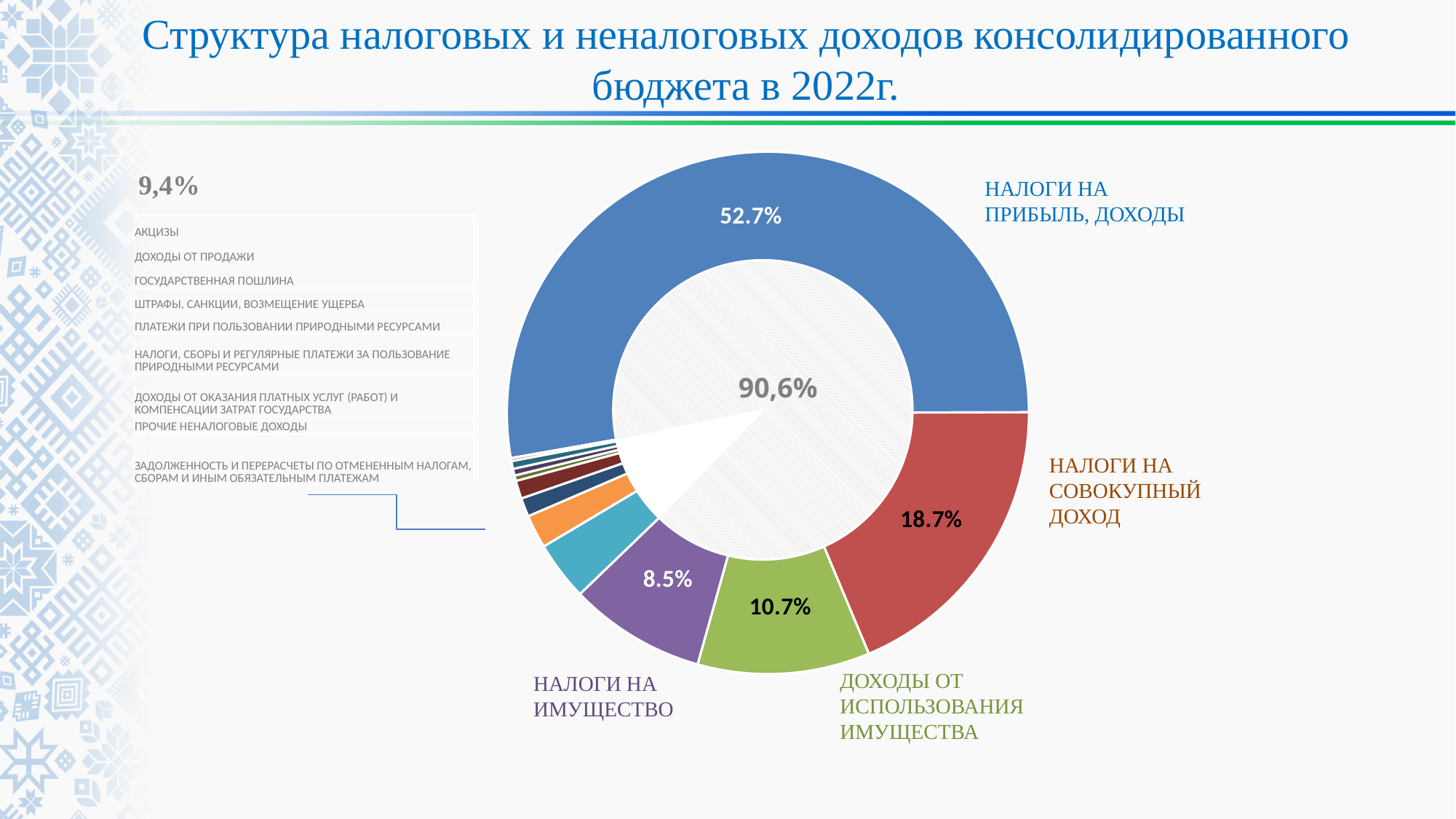
What share of the pie is labelled for НАЛОГИ НА СОВОКУПНЫЙ ДОХОД? 18.7% By how many percentage points does НАЛОГИ НА ПРИБЫЛЬ, ДОХОДЫ exceed НАЛОГИ НА СОВОКУПНЫЙ ДОХОД? 34.0 percentage points What kind of chart is shown on the slide? pie chart (donut) Which is larger: ДОХОДЫ ОТ ИСПОЛЬЗОВАНИЯ ИМУЩЕСТВА or НАЛОГИ НА ИМУЩЕСТВО? ДОХОДЫ ОТ ИСПОЛЬЗОВАНИЯ ИМУЩЕСТВА What value is printed in the centre of the donut chart? 90,6% What share is given for the group of small categories listed in the box on the left? 9,4% How many small categories are listed in the box on the left of the chart? 9 What share of the pie is labelled for НАЛОГИ НА ИМУЩЕСТВО? 8.5% Which labelled slice of the pie is the largest? НАЛОГИ НА ПРИБЫЛЬ, ДОХОДЫ What share of the pie is labelled for НАЛОГИ НА ПРИБЫЛЬ, ДОХОДЫ? 52.7% What share of the pie is labelled for ДОХОДЫ ОТ ИСПОЛЬЗОВАНИЯ ИМУЩЕСТВА? 10.7% Which of the four labelled slices of the pie is the smallest? НАЛОГИ НА ИМУЩЕСТВО